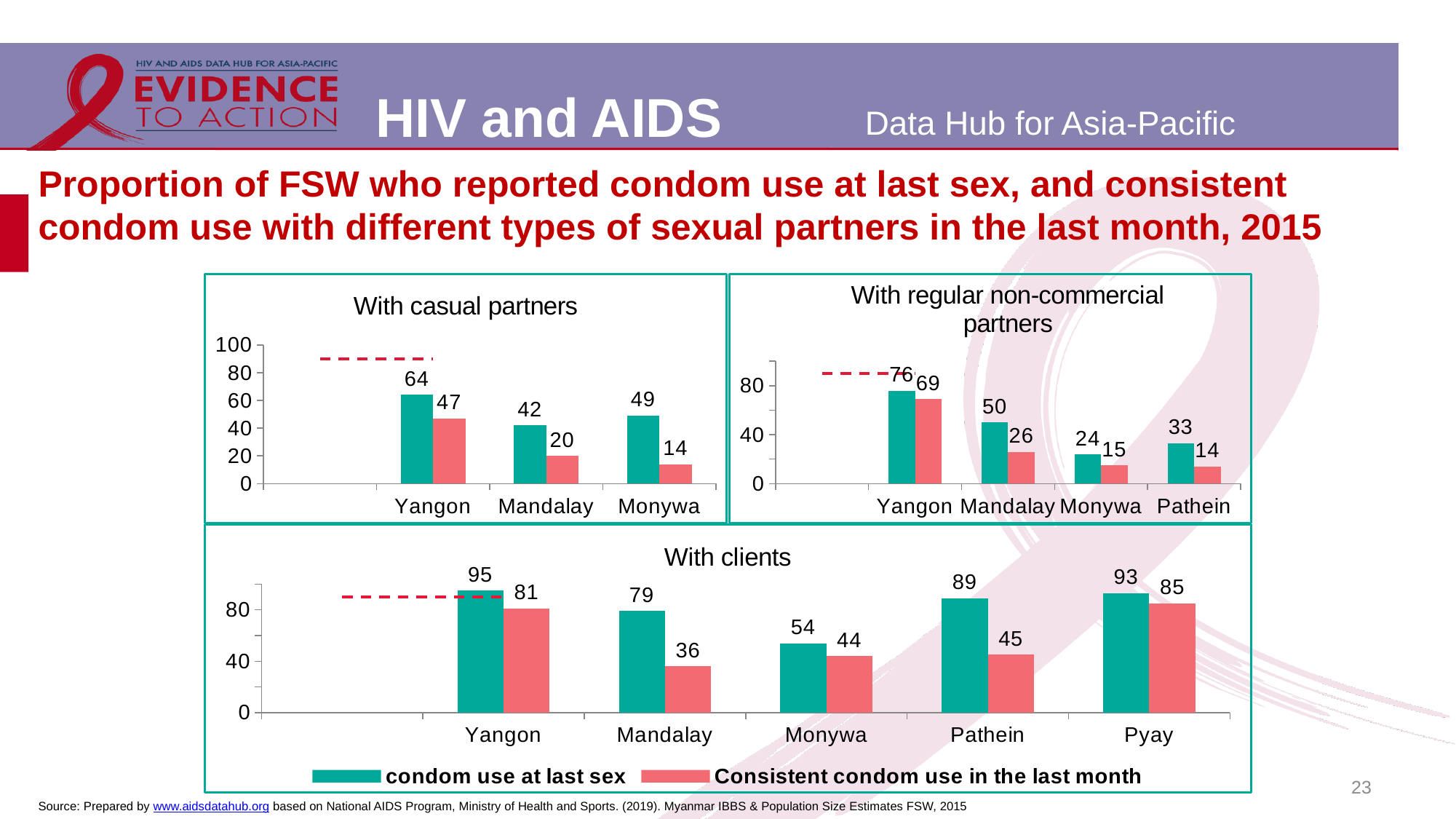
In the 'With clients' chart, which city has the lowest value for consistent condom use in the last month? Mandalay In the 'With clients' chart, which city has the highest value for condom use at last sex? Yangon In the 'With casual partners' chart, what is the value for condom use at last sex in Yangon? 64 In the 'With regular non-commercial partners' chart, what is the value for consistent condom use in the last month in Mandalay? 26 How many cities are shown on the x axis of the 'With casual partners' chart? 3 In the 'With clients' chart, what is the difference between condom use at last sex and consistent condom use in the last month for Mandalay? 43 How many cities are shown on the x axis of the 'With clients' chart? 5 In the 'With regular non-commercial partners' chart, what is the difference between condom use at last sex and consistent condom use in the last month for Yangon? 7 In the 'With casual partners' chart, what is the value for consistent condom use in the last month in Monywa? 14 How many series does the legend at the bottom of the slide list? 2 What type of chart is the 'With clients' chart? Bar chart In the 'With regular non-commercial partners' chart, which is larger: condom use at last sex in Pathein or in Monywa? Pathein